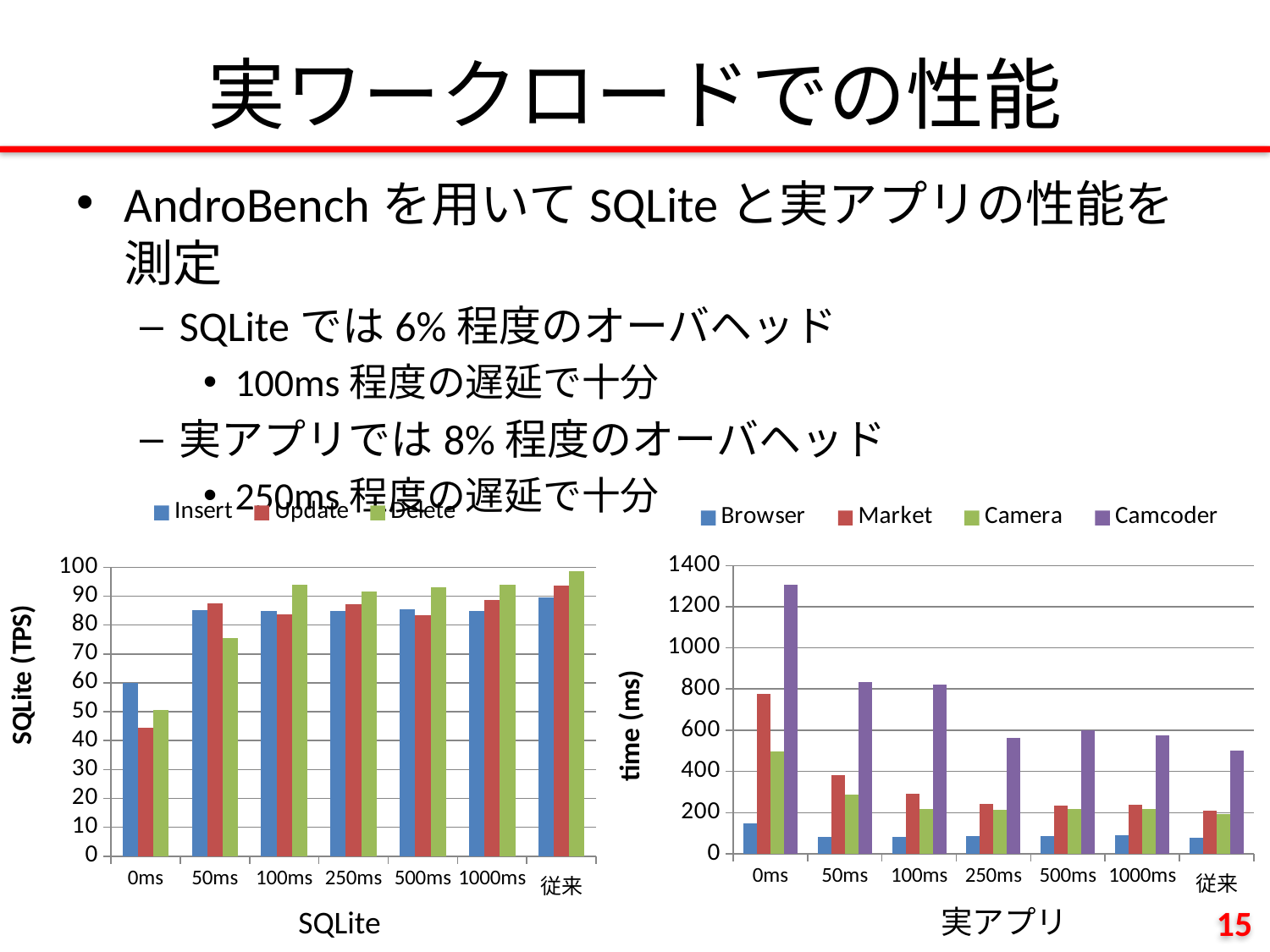
In the 実アプリ chart, which series has the highest value at 0ms? Camcoder In the 実アプリ chart, which is larger at 50ms, Market or Camera? Market In the 実アプリ chart, what is the label of the y axis? time (ms) In the SQLite chart, how many categories are shown on the x axis? 7 In the 実アプリ chart, how many series does the legend list? 4 In the 実アプリ chart, is the Camcoder value at 0ms greater or less than 1200? greater In the SQLite chart, which series has the highest value at 従来? Delete In the SQLite chart, is the Delete value at 50ms greater or less than 80? less In the SQLite chart, is the Update value at 0ms greater or less than 50? less What kind of chart is the 実アプリ chart? bar chart In the SQLite chart, how many series does the legend list? 3 In the SQLite chart, which series has the lowest value at 0ms? Update